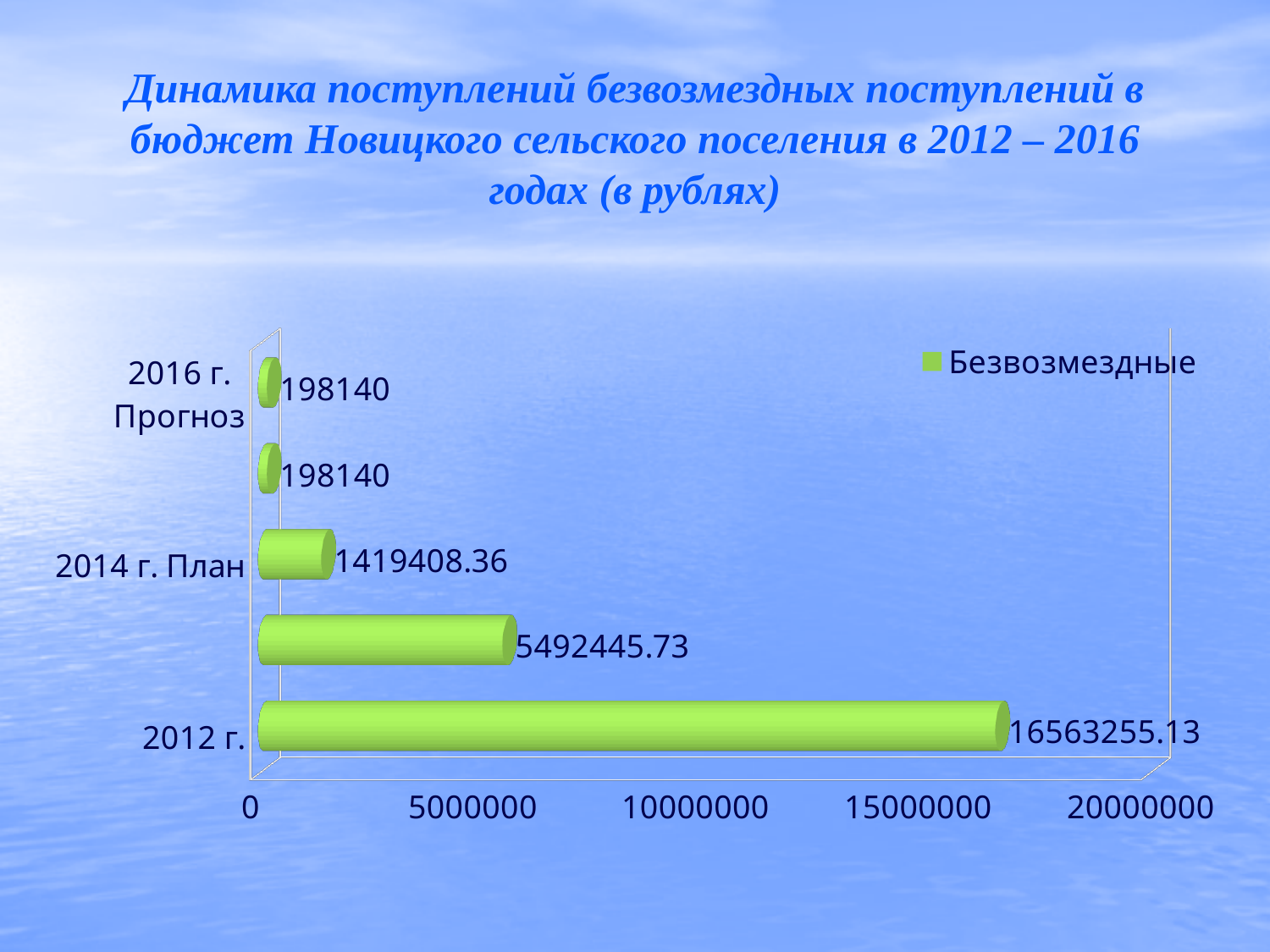
Which category has the highest value? 2012 г. What is the value for 2014 г. План? 1419408.36 Is the value for 2014 г. План greater or less than 5000000? less What is the difference between the values for 2014 г. План and 2016 г. Прогноз? 1221268.36 What is the difference between the values for 2012 г. and 2014 г. План? 15143846.77 What is the value for 2016 г. Прогноз? 198140 How many series does the legend list? 1 How many bars are plotted in the chart? 5 What is the value for 2012 г.? 16563255.13 Which is larger, the value for 2014 г. План or the value for 2016 г. Прогноз? 2014 г. План Is the value for 2012 г. greater or less than 15000000? greater What kind of chart is shown on the slide? bar chart